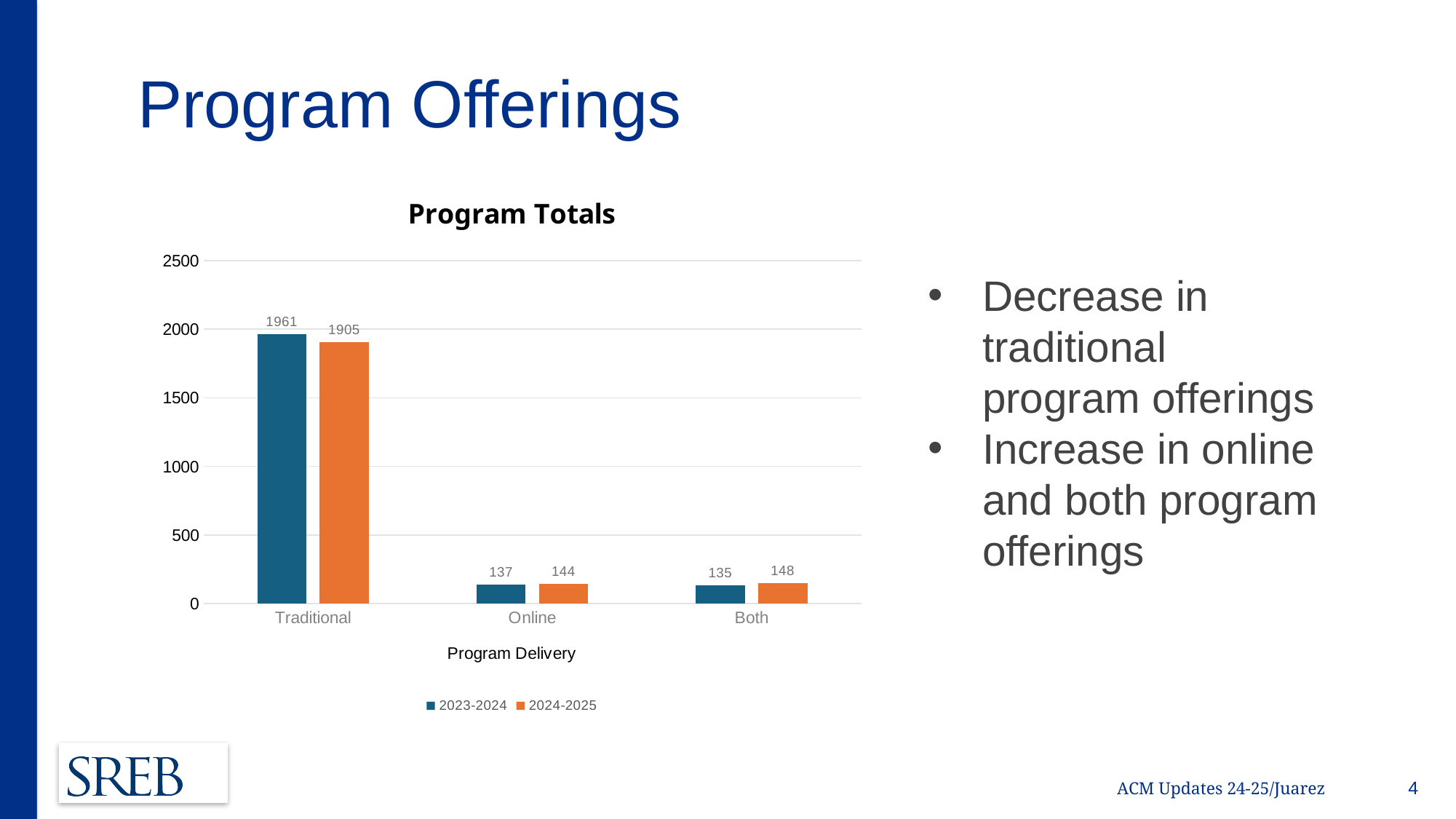
Which is larger for Online: the 2023-2024 value or the 2024-2025 value? 2024-2025 What is the value for Online in the 2024-2025 series? 144 What is the value for Both in the 2023-2024 series? 135 What is the difference between the 2023-2024 and 2024-2025 values for Traditional? 56 What is the value for Traditional in the 2023-2024 series? 1961 How many program delivery categories are shown on the x axis? 3 What is the difference between the 2024-2025 and 2023-2024 values for Both? 13 What kind of chart is shown on the slide? Bar chart Which program delivery category has the lowest value in the 2023-2024 series? Both How many series does the legend list? 2 Which program delivery category has the highest value in the 2024-2025 series? Traditional Is the 2024-2025 value for Traditional greater or less than 1500? greater